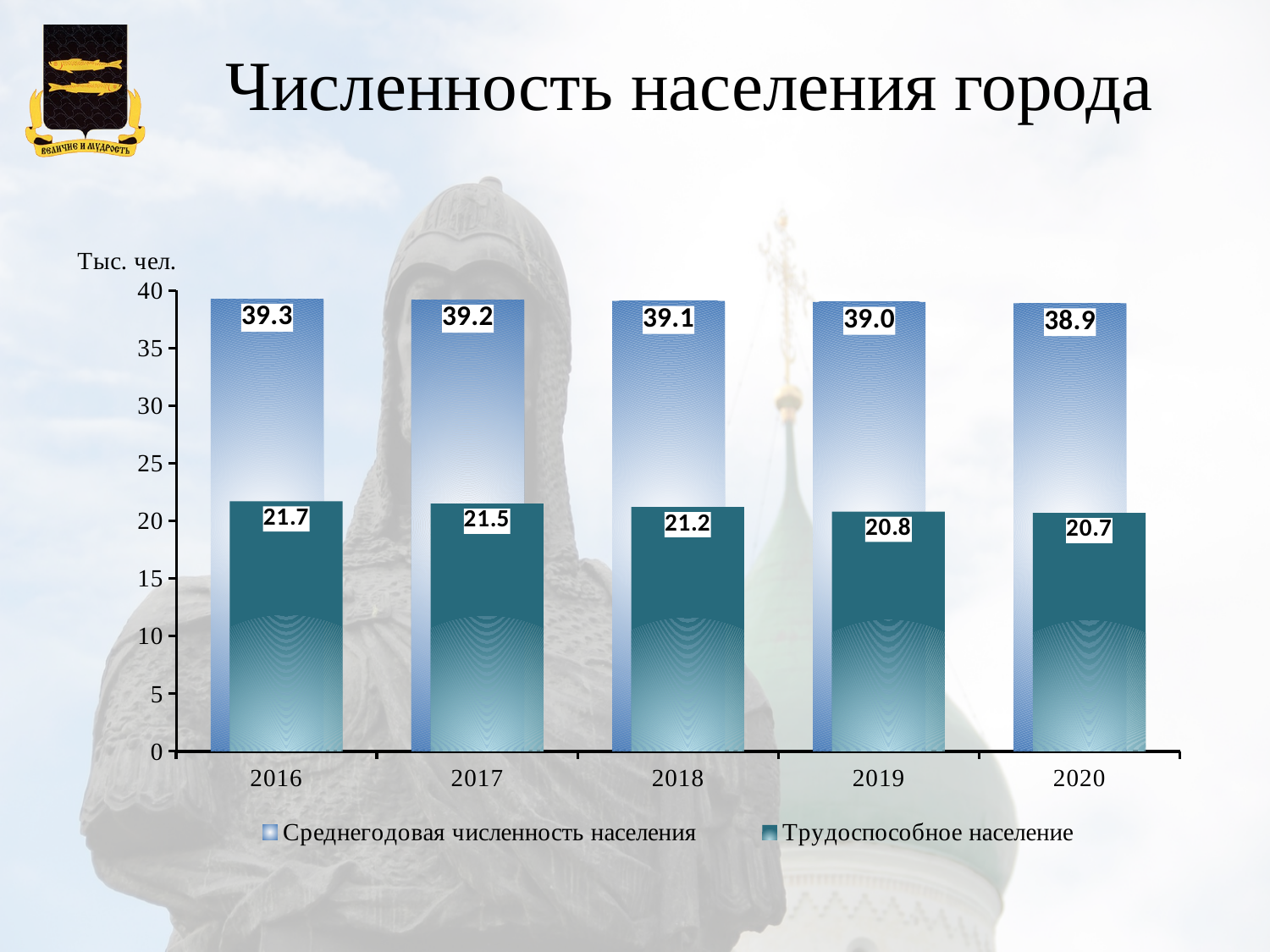
What kind of chart is shown on the slide? bar chart Is the value for Трудоспособное население in 2018 greater or less than 20? greater How many series does the legend list? 2 How many years are shown on the x axis? 5 What is the difference between Среднегодовая численность населения and Трудоспособное население in 2018? 17.9 What is the difference between the Трудоспособное население values for 2016 and 2020? 1.0 Which is larger: Трудоспособное население in 2017 or in 2019? 2017 What is the value of Трудоспособное население for 2020? 20.7 What is the value of Среднегодовая численность населения for 2016? 39.3 What is the value of Трудоспособное население for 2019? 20.8 Which year has the lowest value for Среднегодовая численность населения? 2020 Which year has the highest value for Трудоспособное население? 2016